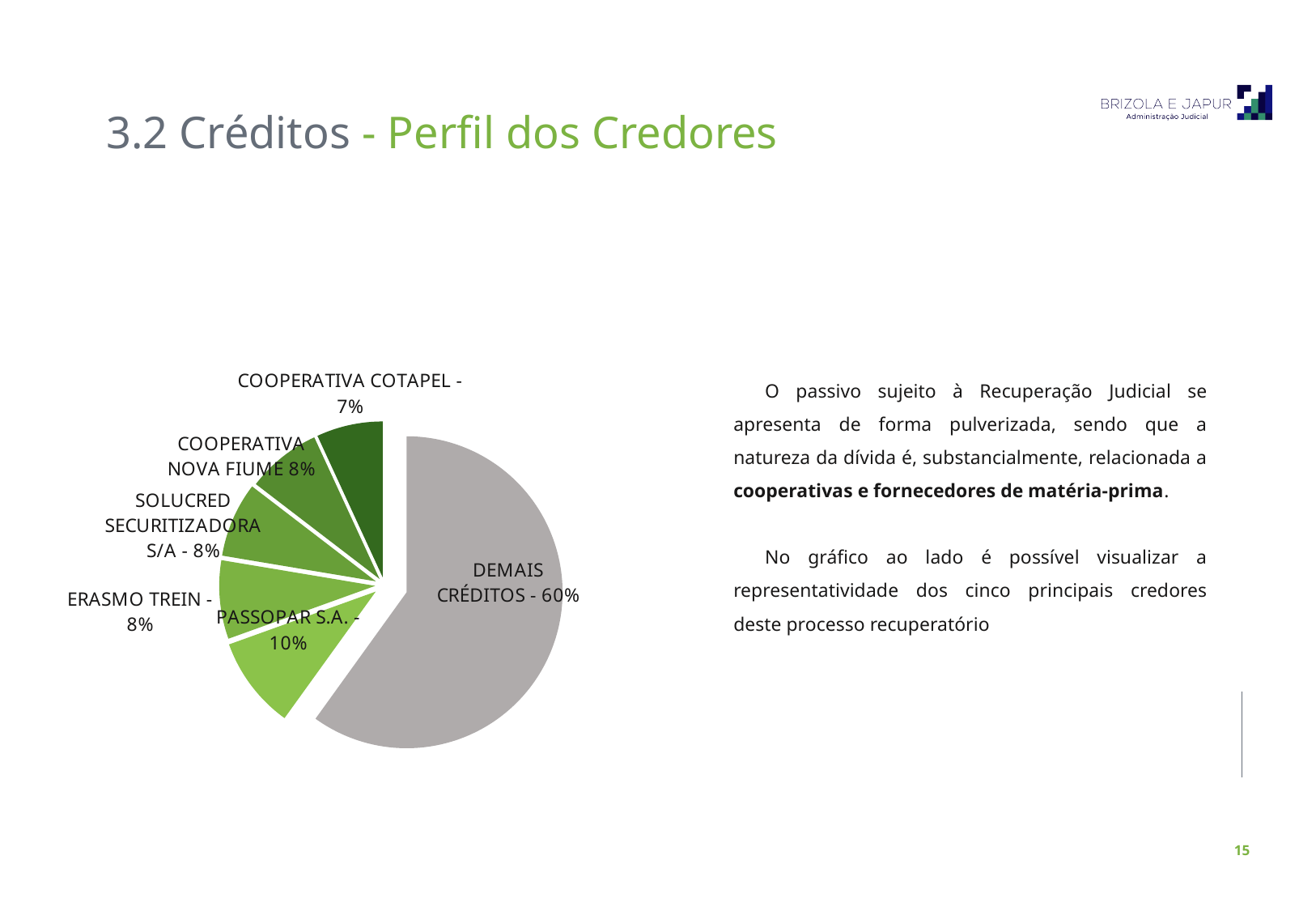
What is the value shown for COOPERATIVA COTAPEL? 7% What is the difference between the share of DEMAIS CRÉDITOS and the share of PASSOPAR S.A.? 50% Which slice of the pie is the smallest? COOPERATIVA COTAPEL How many slices does the pie chart have? 6 Which slice of the pie is the largest? DEMAIS CRÉDITOS What colour is the DEMAIS CRÉDITOS slice? Grey What share of the pie does DEMAIS CRÉDITOS represent? 60% What is the value shown for PASSOPAR S.A.? 10% What is the value shown for SOLUCRED SECURITIZADORA S/A? 8% What is the value shown for ERASMO TREIN? 8% What kind of chart is shown on the slide? Pie chart Which is larger, the share of PASSOPAR S.A. or the share of COOPERATIVA NOVA FIUME? PASSOPAR S.A.